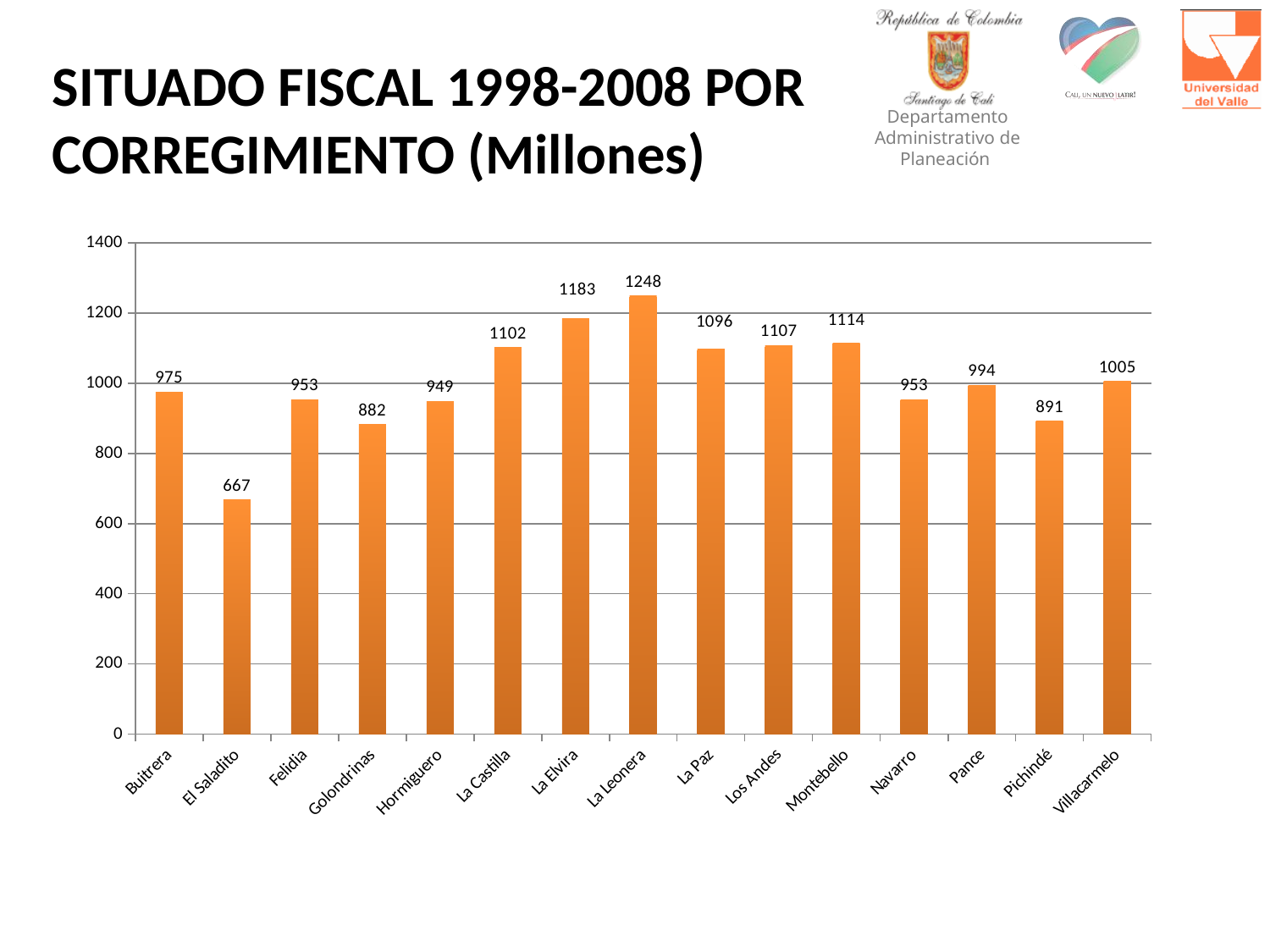
How many corregimientos are shown on the x axis? 15 Is the value for Pichindé greater or less than 1000? less What is the value for Montebello? 1114 What kind of chart is shown on the slide? bar chart What is the difference between the values for La Elvira and La Castilla? 81 What is the difference between the values for La Leonera and El Saladito? 581 Which corregimiento has the lowest value? El Saladito Which is larger, the value for Buitrera or the value for Pance? Pance What is the title of the slide? SITUADO FISCAL 1998-2008 POR CORREGIMIENTO (Millones) Which corregimiento has the highest value? La Leonera What is the value for La Leonera? 1248 What is the value for El Saladito? 667